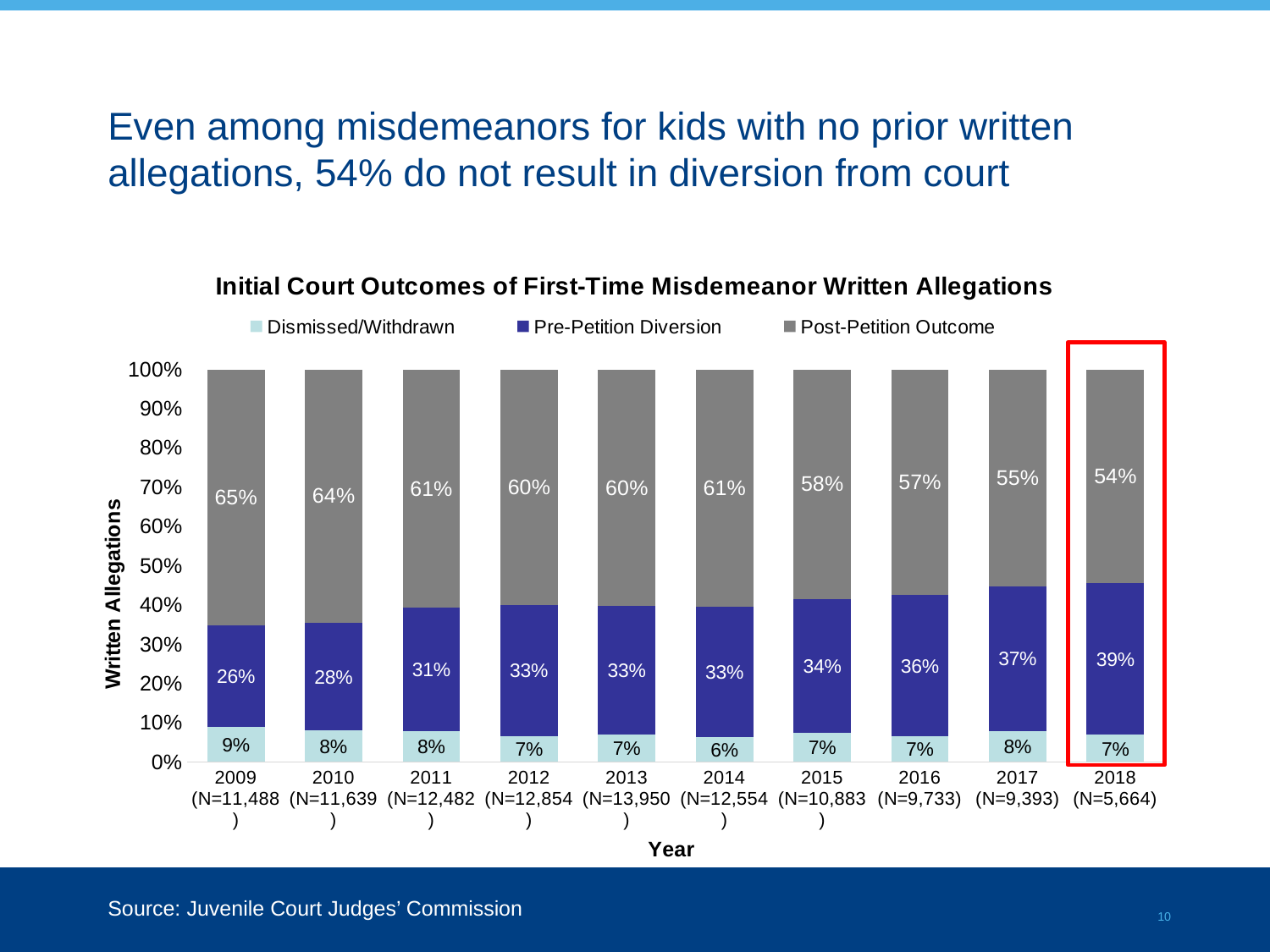
What is the Pre-Petition Diversion value for 2009? 26% What is the title of the chart? Initial Court Outcomes of First-Time Misdemeanor Written Allegations What kind of chart is shown? Stacked bar chart What is the difference between the Pre-Petition Diversion values for 2018 and 2009? 13 percentage points How many years are shown on the x axis? 10 Which year has the lowest Pre-Petition Diversion value? 2009 What is the Post-Petition Outcome value for 2018? 54% Which is larger, the Post-Petition Outcome value for 2015 or for 2017? 2015 What is the Dismissed/Withdrawn value for 2014? 6% Which year has the highest Post-Petition Outcome value? 2009 How many series does the legend list? 3 Does the Pre-Petition Diversion value generally rise or fall from 2009 to 2018? Rise